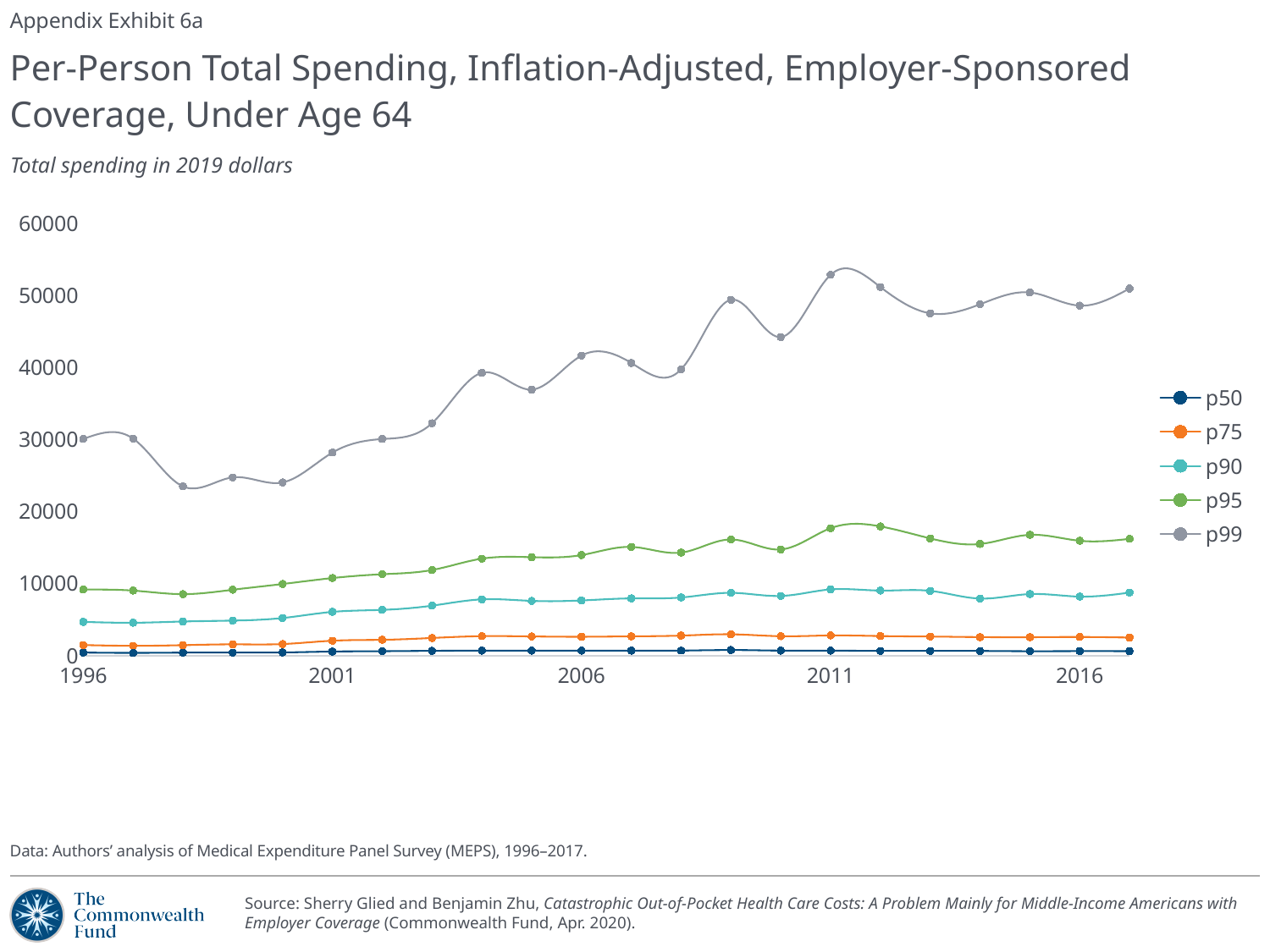
Is the value for p95 in 2016 greater or less than 10000? greater Is the value for p99 in 1996 greater or less than 40000? less Which series has the highest values throughout the chart? p99 Is the value for p99 larger in 1996 or in 2011? 2011 What is the subtitle shown under the chart title? Total spending in 2019 dollars Is the value for p99 in 2011 greater or less than 50000? greater Which series has the lowest values throughout the chart? p50 What colour is the p75 line in the legend? orange How many series does the legend list? 5 Overall, do the p99 values rise or fall from 1996 to 2017? rise What kind of chart is shown on the slide? line chart